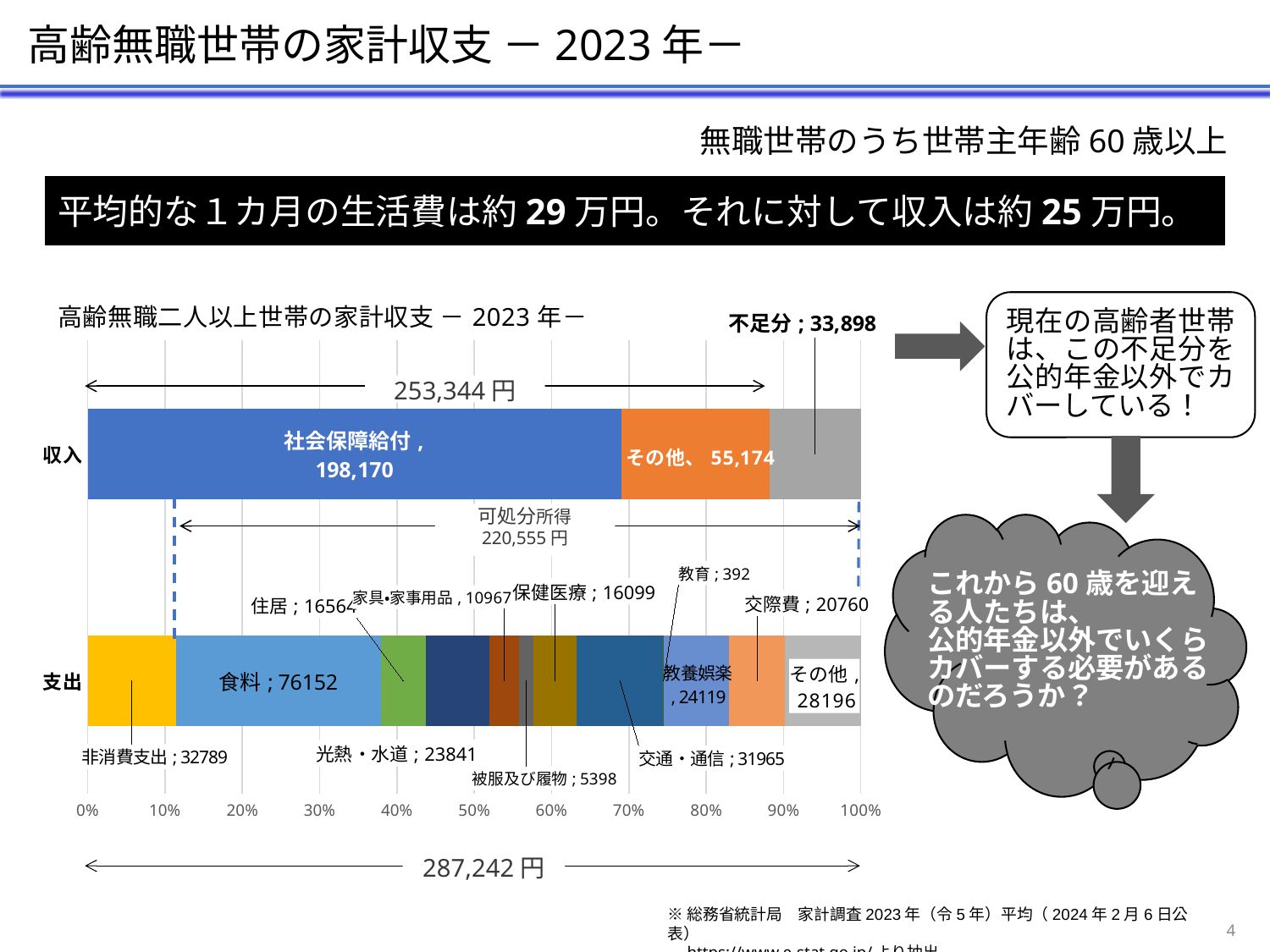
Which is larger in the 支出 bar, 光熱・水道 or 交際費? 光熱・水道 What is the title of the chart? 高齢無職二人以上世帯の家計収支 － 2023年－ What is the value labelled 不足分? 33,898 What kind of chart is shown on the slide? Stacked bar chart What is the value of 食料 in the 支出 bar? 76152 How many segments make up the 支出 bar? 12 Which segment of the 支出 bar has the smallest value? 教育 What is the difference between 社会保障給付 (198,170) and その他 (55,174) in the 収入 bar? 142,996 What is the value of 社会保障給付 in the 収入 bar? 198,170 What is the value of 交通・通信 in the 支出 bar? 31965 Which segment of the 支出 bar has the largest value? 食料 What is the total of the 支出 bar as printed on the slide? 287,242円